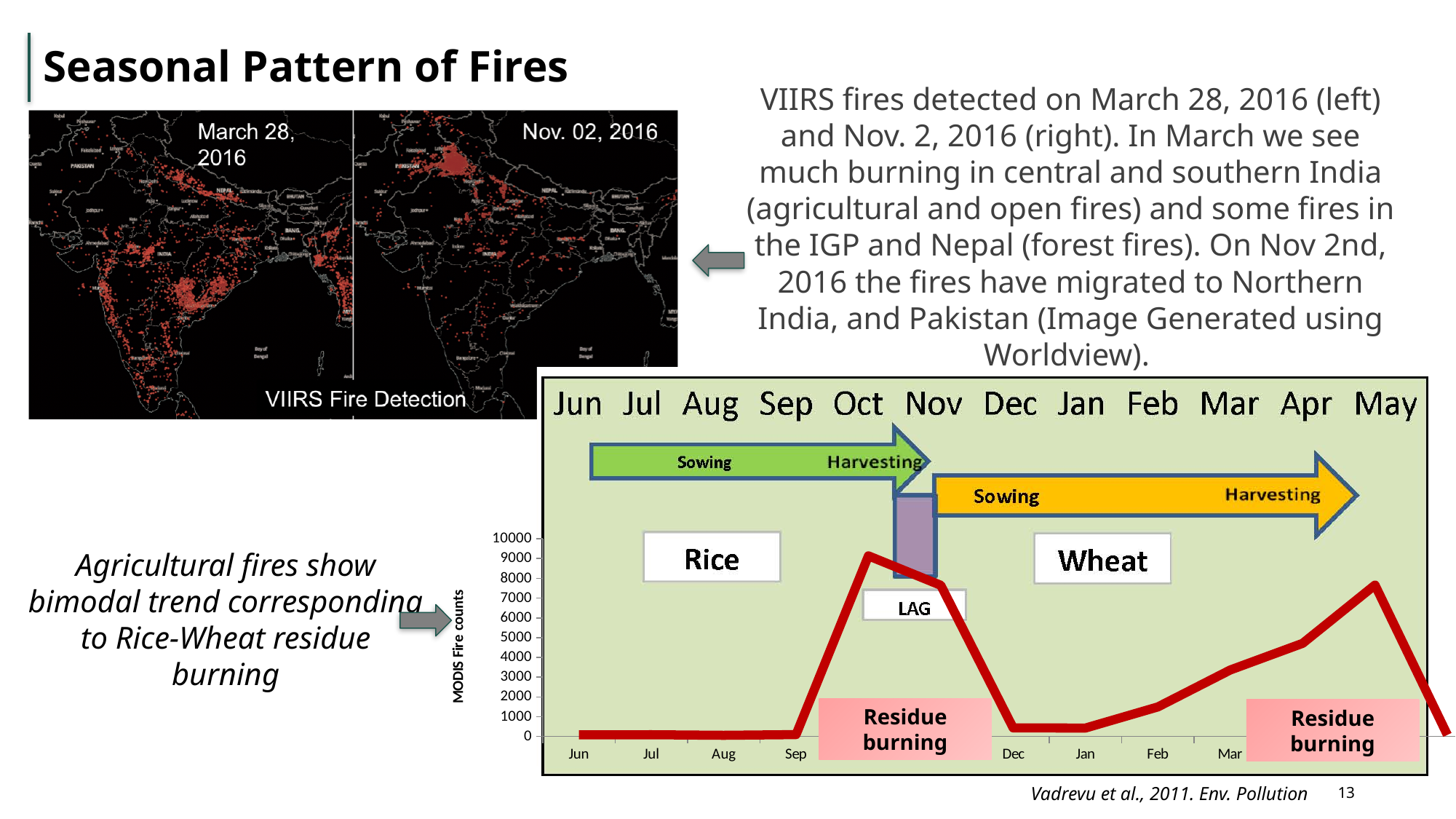
In the MODIS Fire counts chart, is the value for Dec greater or less than 1000? less What is the label on the vertical axis of the fire counts chart? MODIS Fire counts In the MODIS Fire counts chart, which month has the highest fire count? Oct In the MODIS Fire counts chart, is the value for Mar greater or less than 2000? greater In the MODIS Fire counts chart, is the value for Apr greater or less than 6000? less What kind of chart is the MODIS Fire counts chart at the bottom right of the slide? line chart How many months are shown along the top of the MODIS Fire counts chart? 12 In the MODIS Fire counts chart, do the fire counts rise or fall from Dec to Apr? rise In the MODIS Fire counts chart, which month has the larger fire count, Dec or Mar? Mar In the MODIS Fire counts chart, which month has the larger fire count, Oct or Apr? Oct